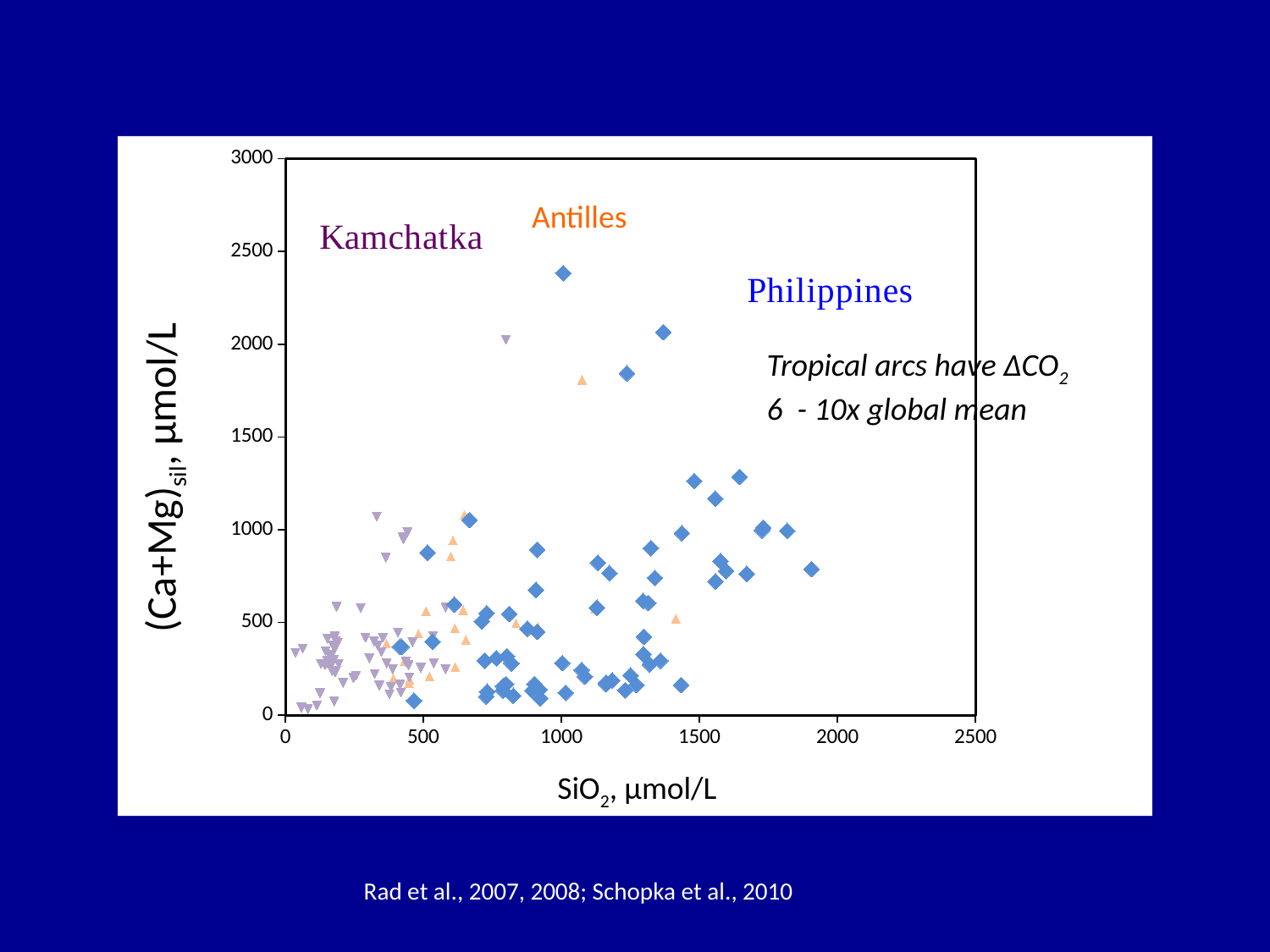
What kind of chart is shown on the slide? scatter plot Which series contains the point with the highest (Ca+Mg)sil value? Philippines Which series reaches the highest SiO2 values along the x axis? Philippines Is the highest (Ca+Mg)sil value on the chart greater or less than 2500? less Which series has more points plotted, Kamchatka or Antilles? Kamchatka What is the maximum value shown on the y axis? 3000 Is the largest SiO2 value plotted greater or less than 2000? less What is the label of the x axis? SiO2, µmol/L Which series is plotted with blue diamond markers? Philippines How many data series are plotted on the chart? 3 Which series has its points clustered at the lowest SiO2 values? Kamchatka Is the highest (Ca+Mg)sil value on the chart greater or less than 2000? greater